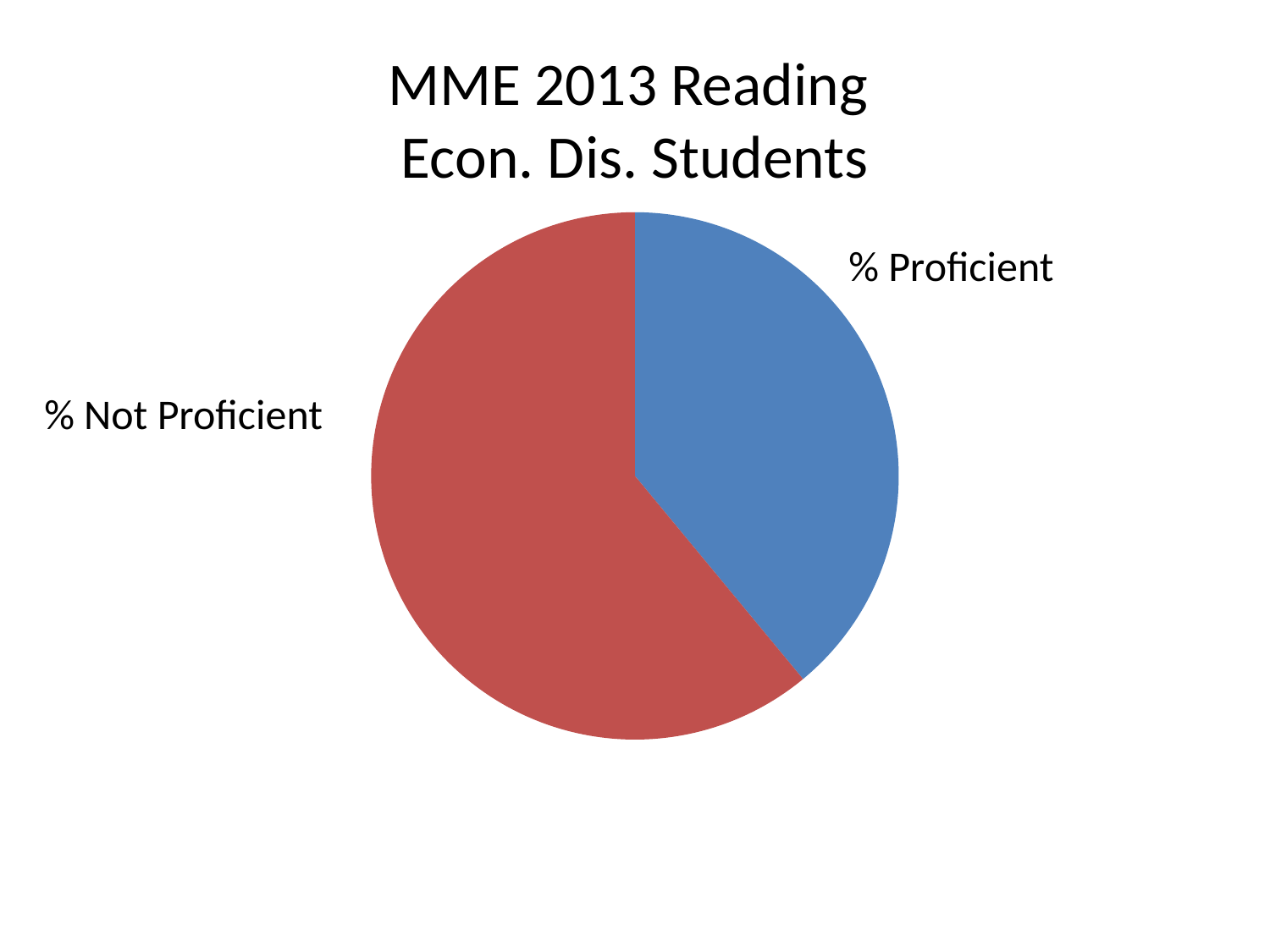
Which slice of the pie chart is the smallest? % Proficient What is the title of the chart? MME 2013 Reading Econ. Dis. Students What kind of chart is shown on the slide? Pie chart How many slices does the pie chart have? 2 Which is larger in the pie chart, % Proficient or % Not Proficient? % Not Proficient What colour is the % Proficient slice? Blue Which slice of the pie chart is the largest? % Not Proficient